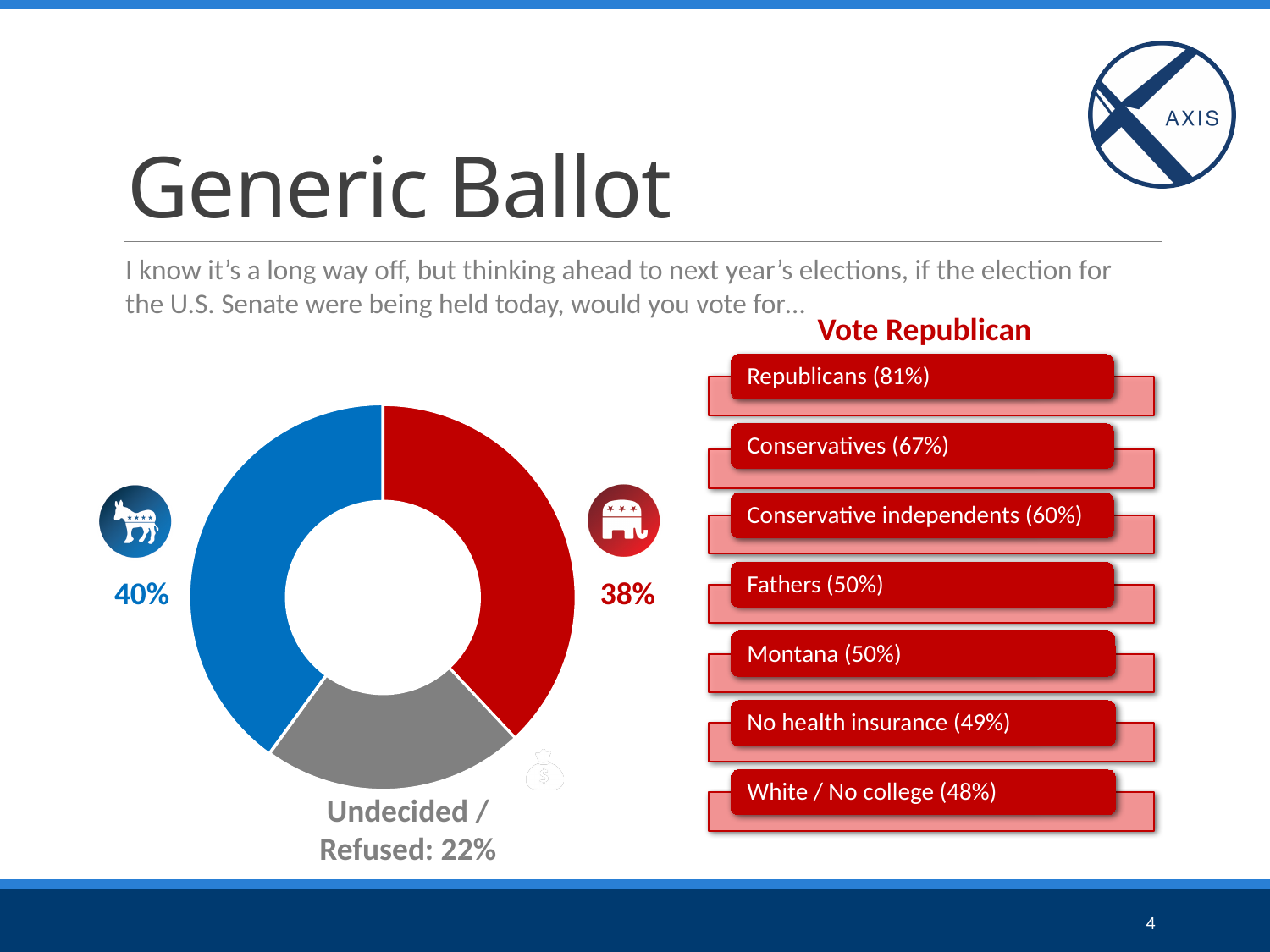
In the donut chart, what is the difference between the blue slice (40%) and the red slice (38%)? 2 percentage points In the donut chart, which is larger: the red slice or the gray Undecided / Refused slice? the red slice (38%) What kind of chart is shown on the left of the slide? donut (pie) chart What colour is the Undecided / Refused slice in the donut chart? gray In the donut chart, what percentage is shown for the red slice with the elephant icon? 38% How many slices does the donut chart have? 3 In the donut chart, how much larger is the blue slice (40%) than the Undecided / Refused slice (22%)? 18 percentage points In the donut chart, what percentage is labelled Undecided / Refused? 22% In the donut chart, what percentage is shown for the blue slice with the donkey icon? 40% Which slice of the donut chart is the largest? the blue slice (40%) What do the three percentages in the donut chart add up to? 100% Which slice of the donut chart is the smallest? Undecided / Refused (22%)